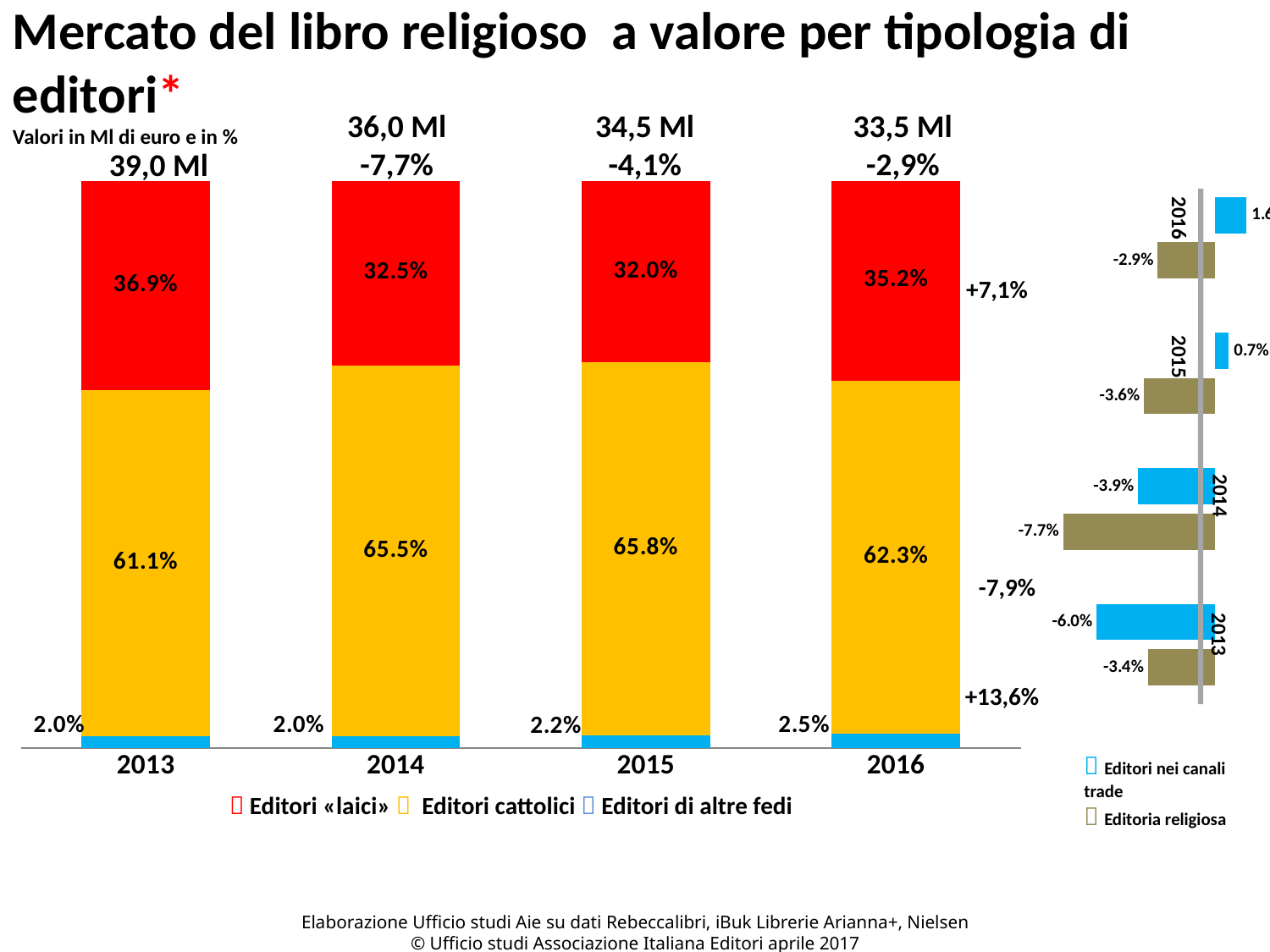
In the stacked bar chart, what share do Editori cattolici hold in 2015? 65.8% In the stacked bar chart, what share do Editori «laici» hold in 2013? 36.9% In the stacked bar chart, what is the total market value shown above the 2014 bar? 36,0 Ml In the stacked bar chart, in which year is the share of Editori «laici» lowest? 2015 How many series does the legend of the stacked bar chart list? 3 In the stacked bar chart, by how many percentage points does the Editori «laici» share in 2013 exceed that in 2016? 1.7 In the stacked bar chart, is the Editori «laici» share larger in 2014 or in 2016? 2016 In the small chart on the right, what is the value for Editoria religiosa in 2014? -7.7% How many years are shown on the x axis of the stacked bar chart? 4 In the stacked bar chart, in which year is the share of Editori di altre fedi highest? 2016 Do the total market values (in Ml) above the bars rise or fall from 2013 to 2016? Fall What kind of chart is the large chart on the left? Stacked bar chart